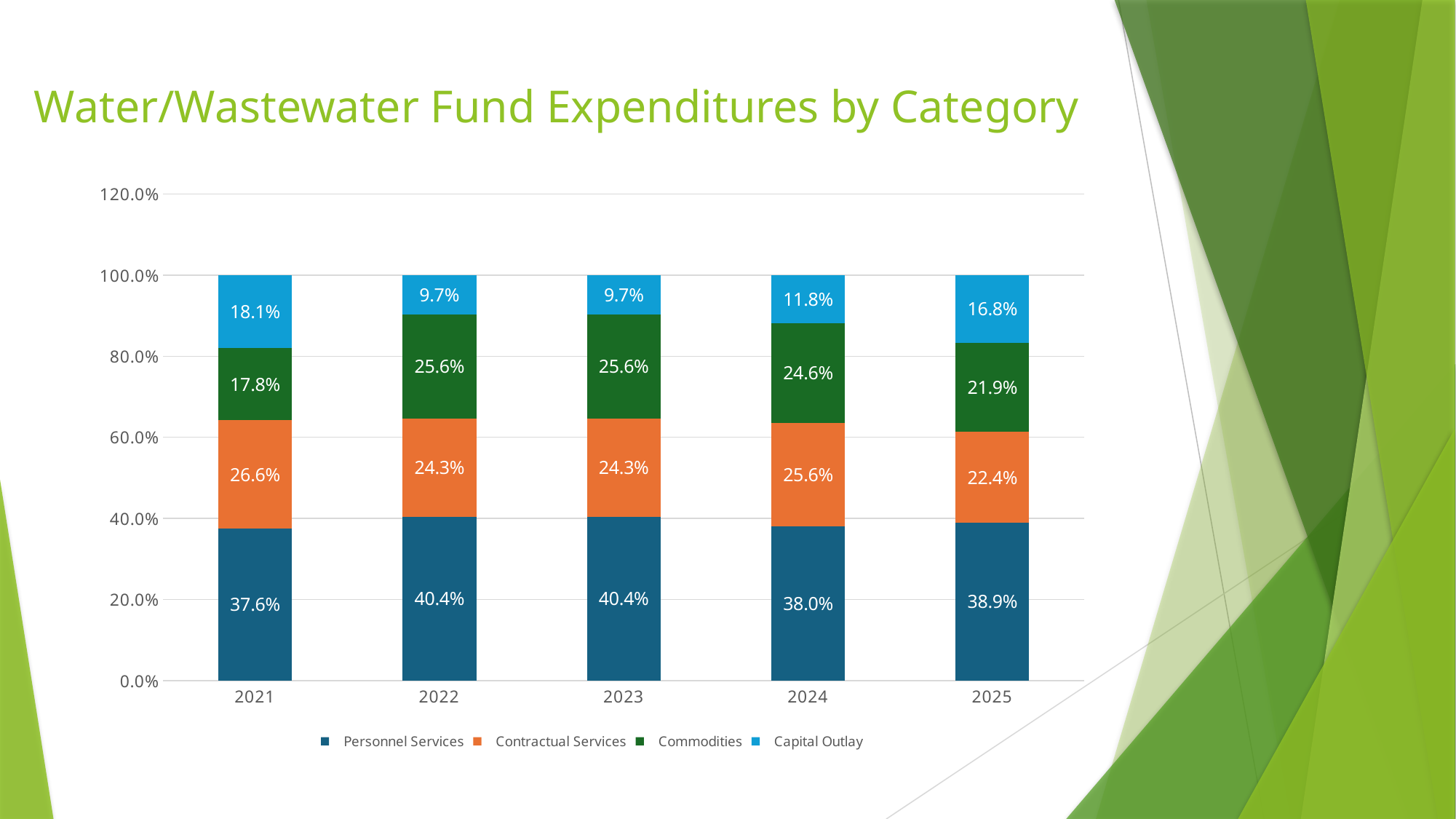
What percentage of Water/Wastewater Fund expenditures went to Personnel Services in 2021? 37.6% By how many percentage points does the Capital Outlay share in 2021 exceed that in 2022? 8.4 percentage points In 2024, which is larger: the Contractual Services share or the Commodities share? Contractual Services What type of chart is shown on the slide? Stacked bar chart In which year is the Contractual Services share the lowest? 2025 What is the Commodities share in 2024? 24.6% In which year is the Capital Outlay share the highest? 2021 How many years are shown on the x axis? 5 What is the Capital Outlay share in 2025? 16.8% In which year is the Commodities share the lowest? 2021 Does the Capital Outlay share rise or fall from 2021 to 2022? Fall How many expenditure categories does the legend list? 4